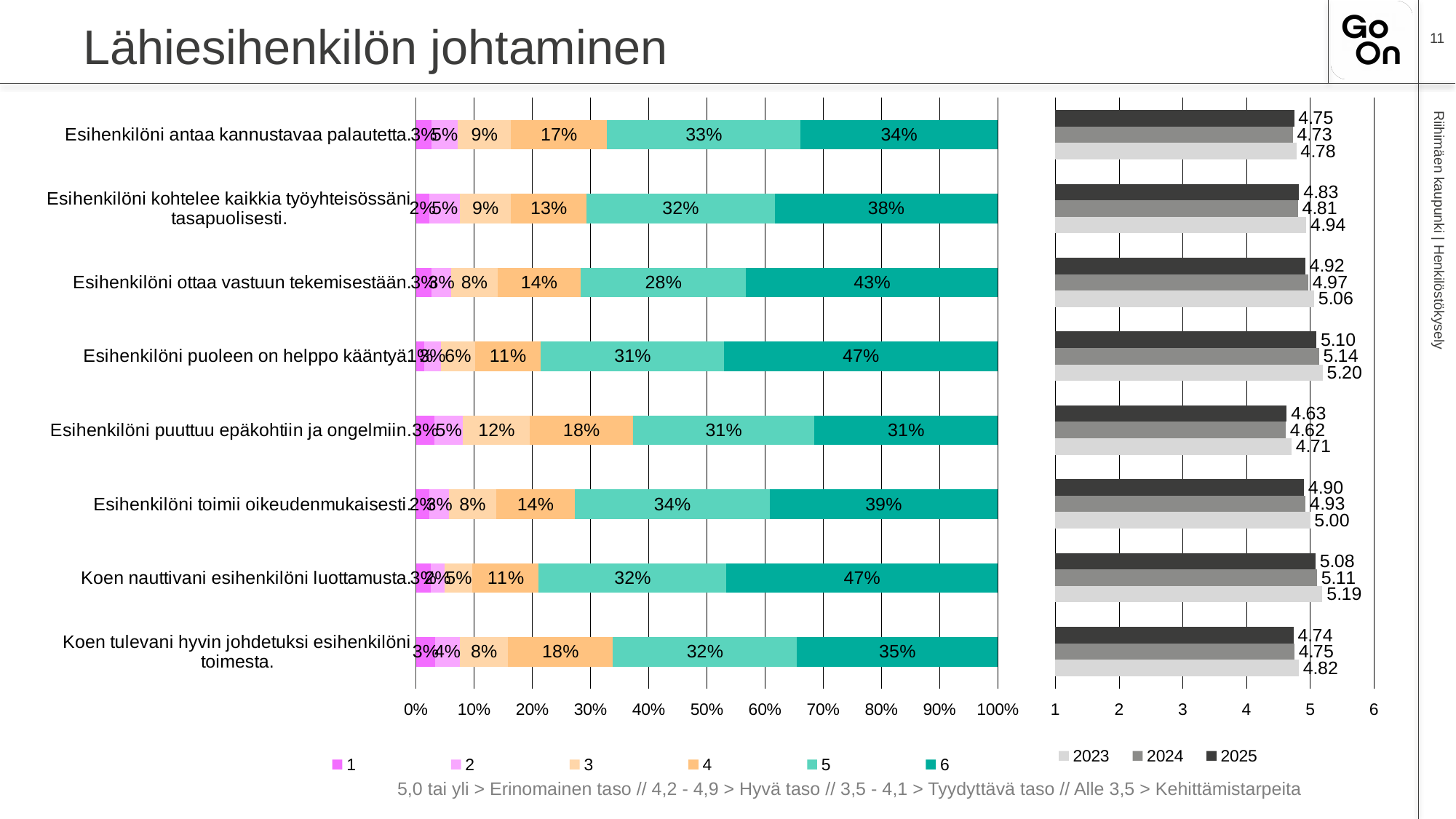
How many series does the legend of the left chart list? 6 In the right chart, what is the 2025 value for "Esihenkilöni puuttuu epäkohtiin ja ongelmiin"? 4.63 In the left chart, what percentage of respondents gave a 6 for "Esihenkilöni ottaa vastuun tekemisestään"? 43% What kind of chart is the left chart on the slide? Stacked bar chart In the right chart, what is the 2023 value for "Esihenkilöni puoleen on helppo kääntyä"? 5.20 In the right chart, which statement has the highest 2023 value? Esihenkilöni puoleen on helppo kääntyä In the right chart, what is the difference between the 2023 and 2025 values for "Esihenkilöni ottaa vastuun tekemisestään"? 0.14 How many series does the legend of the right chart list? 3 How many statements (categories) are shown in the left chart? 8 In the right chart, do the values for "Esihenkilöni puoleen on helppo kääntyä" rise or fall from 2023 to 2025? Fall In the left chart, which statement has a larger share of 4 ratings: "Esihenkilöni puuttuu epäkohtiin ja ongelmiin" or "Esihenkilöni puoleen on helppo kääntyä"? Esihenkilöni puuttuu epäkohtiin ja ongelmiin In the right chart, which statement has the lowest 2025 value? Esihenkilöni puuttuu epäkohtiin ja ongelmiin